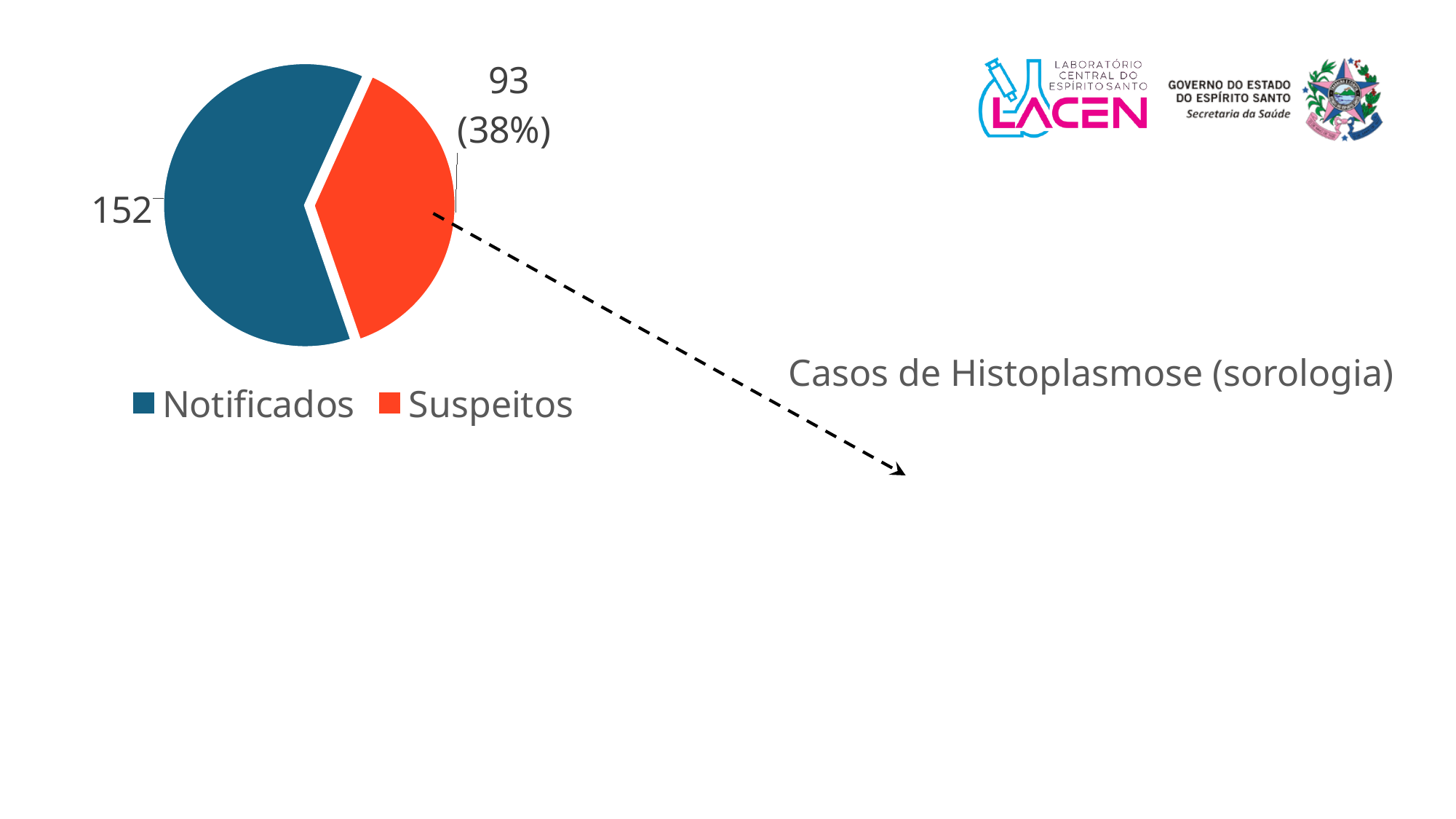
How many entries does the legend list? 2 What colour is the Suspeitos slice? orange-red Which category has the smallest slice? Suspeitos What is the value for Notificados? 152 What is the total of the two slices in the pie chart? 245 What kind of chart is shown on the slide? pie chart What is the difference between the Notificados and Suspeitos values? 59 What percentage share is shown for the Suspeitos slice? 38% Which category has the largest slice? Notificados How many categories does the pie chart have? 2 What is the value for Suspeitos? 93 Which is larger, Notificados or Suspeitos? Notificados